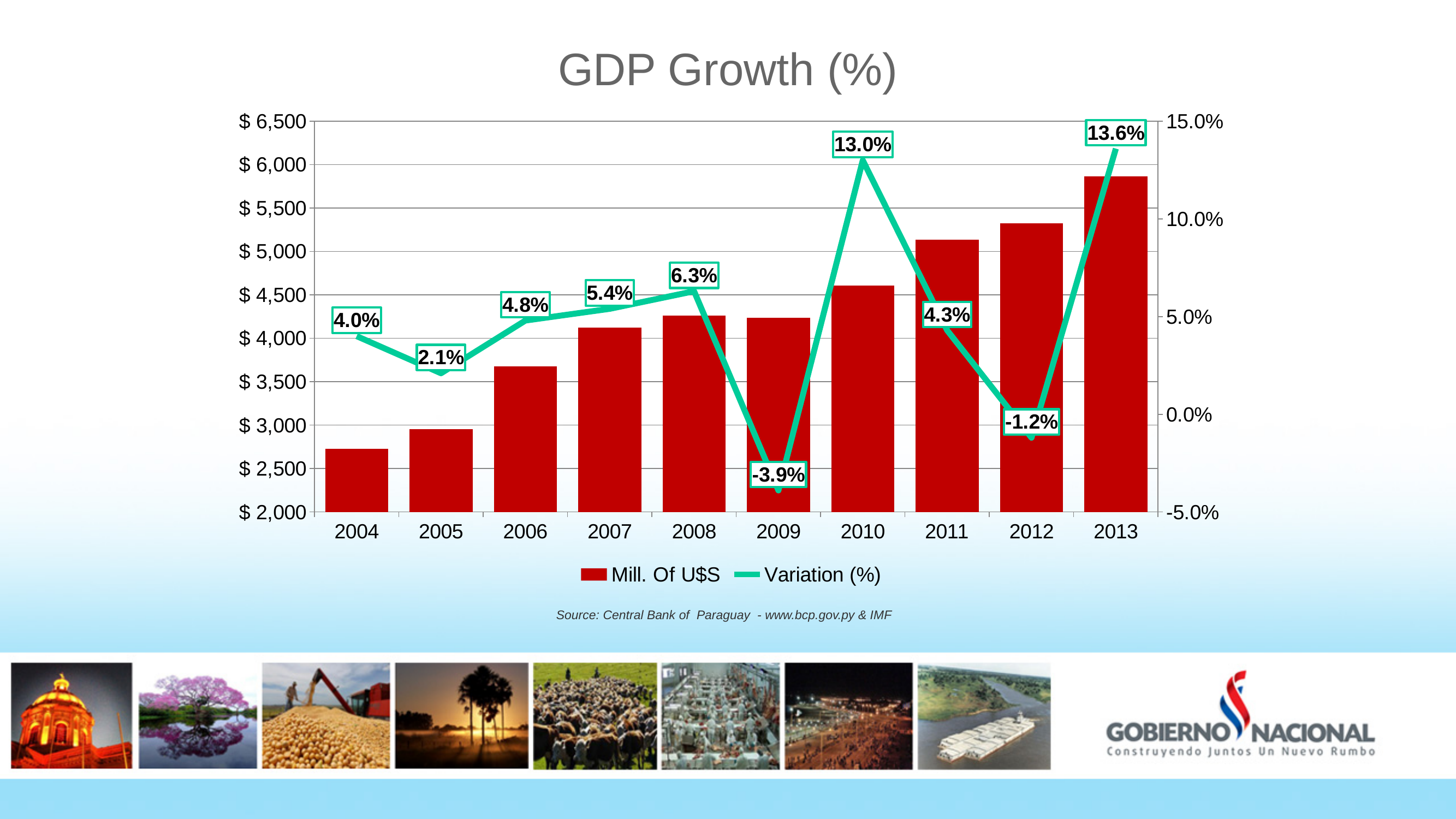
How many years are shown on the x axis? 10 What is the difference between the Variation (%) for 2013 and 2010? 0.6 percentage points Which year has the highest Variation (%)? 2013 What kind of chart is shown on the slide? Combined bar and line chart How many series does the legend list? 2 What is the Variation (%) value for 2005? 2.1% Is the Mill. Of U$S bar for 2013 greater or less than $ 5,500? greater Which year has a larger Variation (%), 2006 or 2011? 2006 What is the Variation (%) value for 2009? -3.9% Which year has the lowest Variation (%)? 2009 What is the Variation (%) value for 2010? 13.0% Is the Mill. Of U$S bar for 2004 greater or less than $ 3,000? less